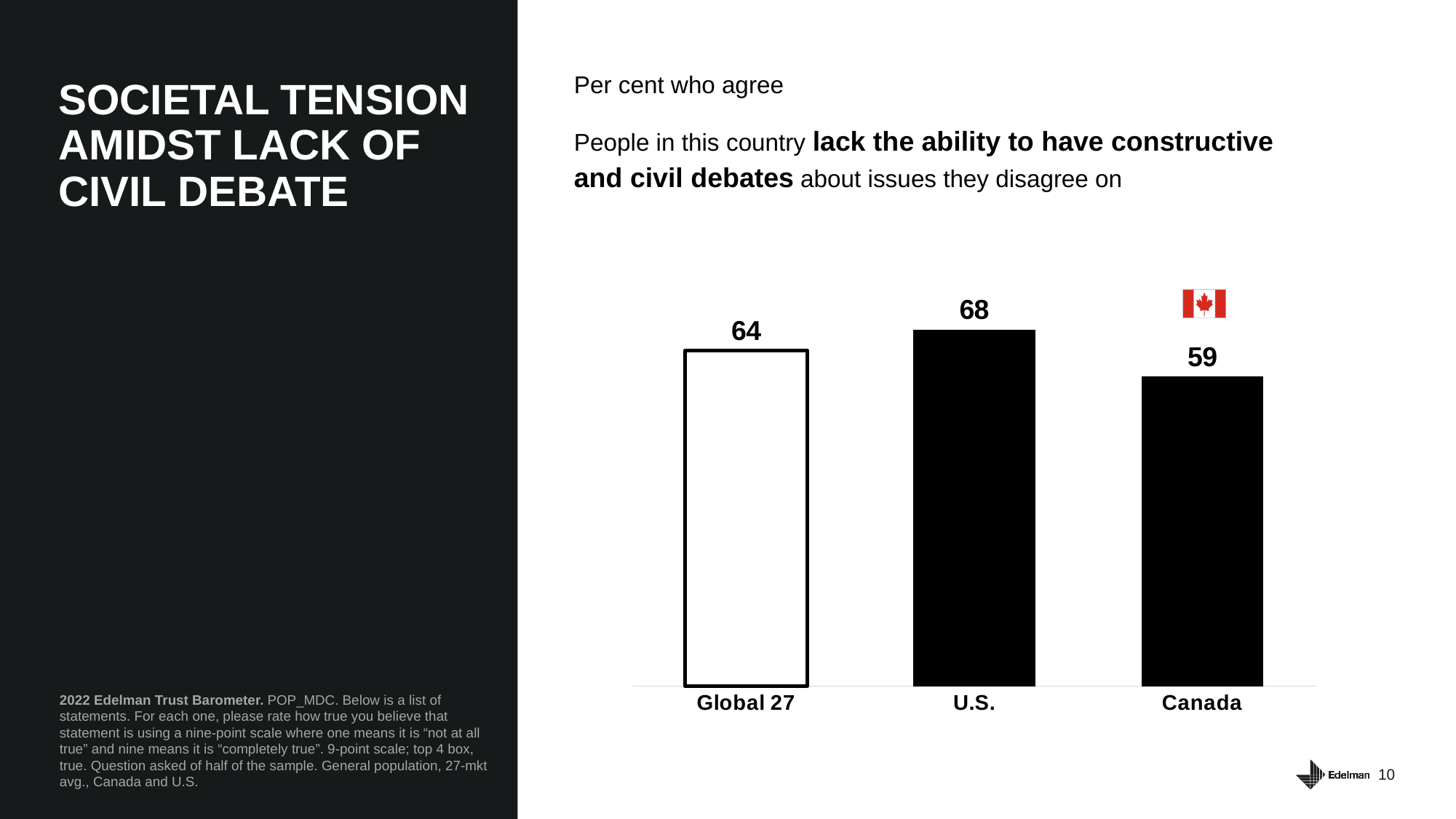
What is the difference between the Global 27 and Canada values? 5 Which bar is drawn as an outline rather than filled in black? Global 27 Which category has the lowest value? Canada What is the value for Canada? 59 What is the difference between the U.S. and Canada values? 9 Which category has a flag icon above its bar? Canada What is the value for the U.S.? 68 Which is larger, the value for Global 27 or the value for the U.S.? U.S. What kind of chart is shown on the slide? Bar chart How many categories are shown in the chart? 3 What is the value for Global 27? 64 Which category has the highest value? U.S.